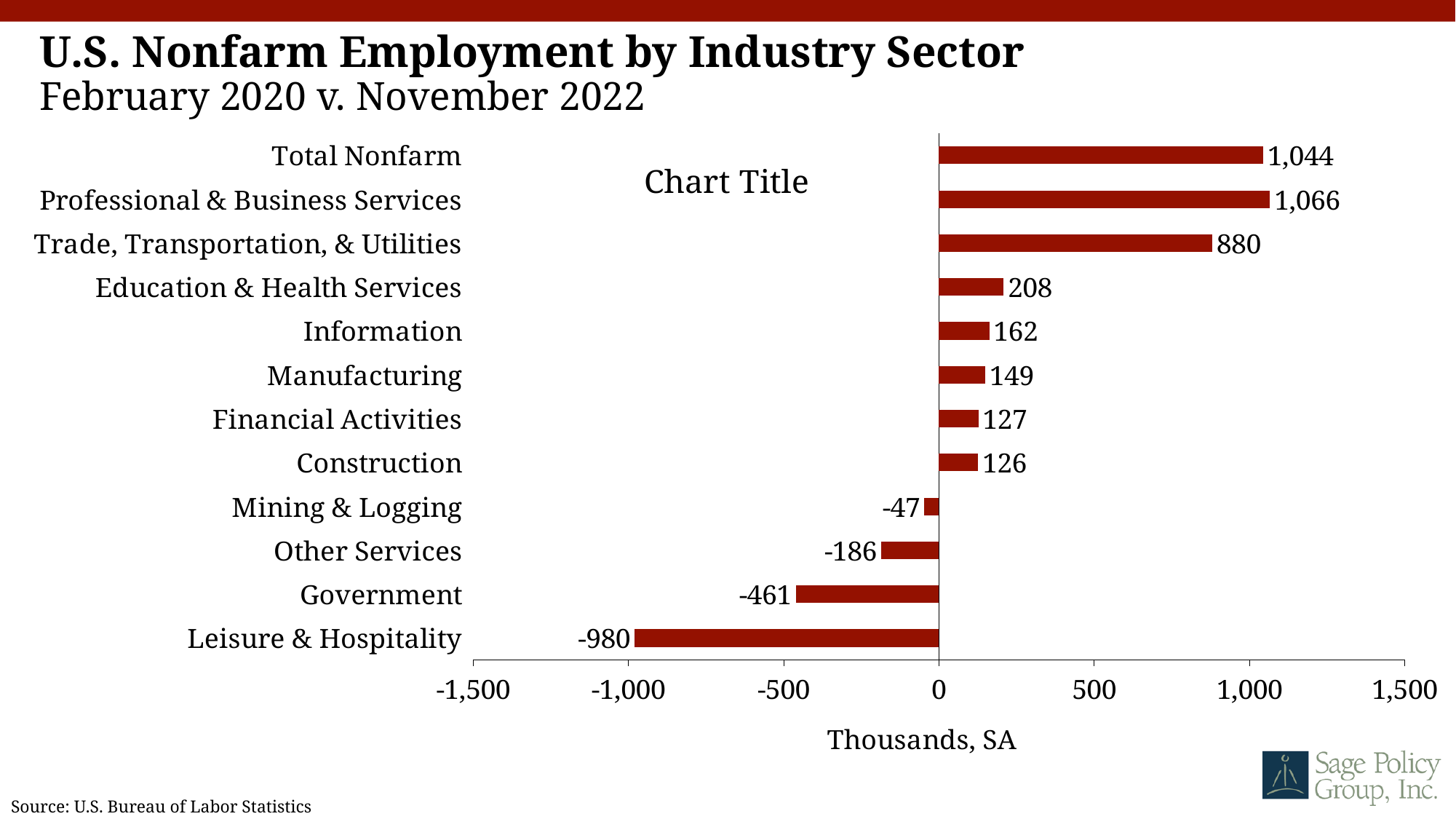
Is the value for Other Services greater or less than -500? greater Which industry sector has the highest value? Professional & Business Services What is the value for Government? -461 What is the value for Leisure & Hospitality? -980 What unit is shown on the horizontal axis label? Thousands, SA What kind of chart is shown on the slide? Bar chart How many categories are shown on the chart? 12 Which is larger, the value for Information or the value for Financial Activities? Information What is the value for Manufacturing? 149 What is the value for Professional & Business Services? 1,066 Which industry sector has the lowest value? Leisure & Hospitality What is the difference between the values for Trade, Transportation, & Utilities and Education & Health Services? 672